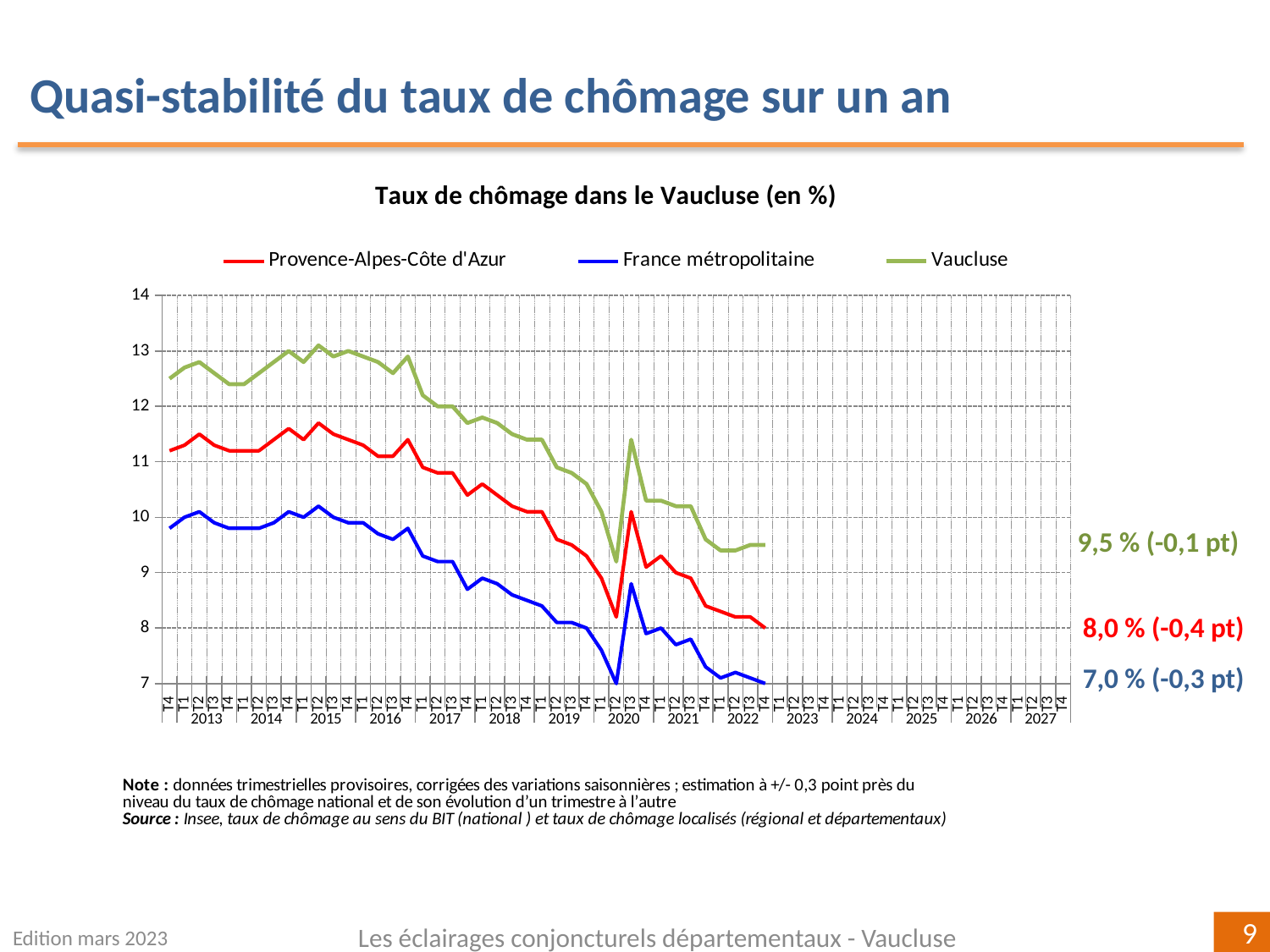
By how much did the Vaucluse rate change over one year, according to the annotation? -0,1 pt Does the Vaucluse unemployment rate overall rise or fall between 2013 and 2022? fall What is the latest unemployment rate shown for France métropolitaine? 7,0 % Which series has the lowest value at the end of the period? France métropolitaine What is the latest unemployment rate shown for Vaucluse? 9,5 % Is the value for Vaucluse at T4 2012 greater or less than 12? greater Which series has the highest value at the end of the period? Vaucluse What is the latest unemployment rate shown for Provence-Alpes-Côte d'Azur? 8,0 % What is the difference between the latest Vaucluse rate and the latest Provence-Alpes-Côte d'Azur rate? 1,5 points What is the title of the chart? Taux de chômage dans le Vaucluse (en %) What kind of chart is shown on the slide? line chart How many series does the legend list? 3